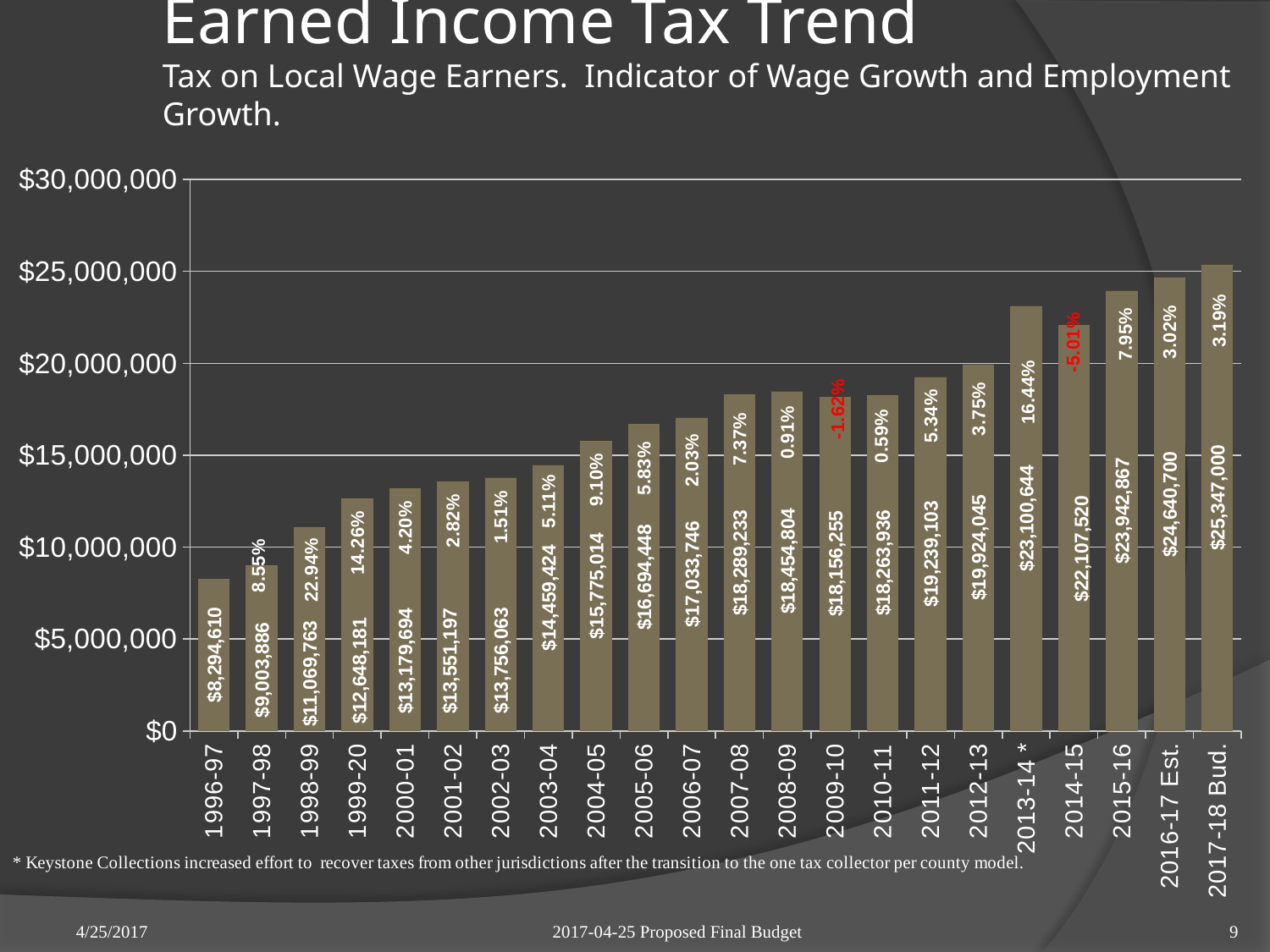
What is the earned income tax value for 2017-18 Bud.? $25,347,000 How many bars are shown in the chart? 22 What is the earned income tax value for 2005-06? $16,694,448 Which year has the highest earned income tax value? 2017-18 Bud. Do the values generally rise or fall from 1996-97 to 2017-18 Bud.? rise Which is larger, the value for 2009-10 or the value for 2010-11? 2010-11 Which year has the lowest earned income tax value? 1996-97 What is the difference between the 2013-14 * value and the 2014-15 value? $993,124 Is the value for 2012-13 greater or less than $20,000,000? less What percentage change is shown for 2014-15? -5.01% What kind of chart is shown on the slide? bar chart What percentage change is shown for 2013-14 *? 16.44%